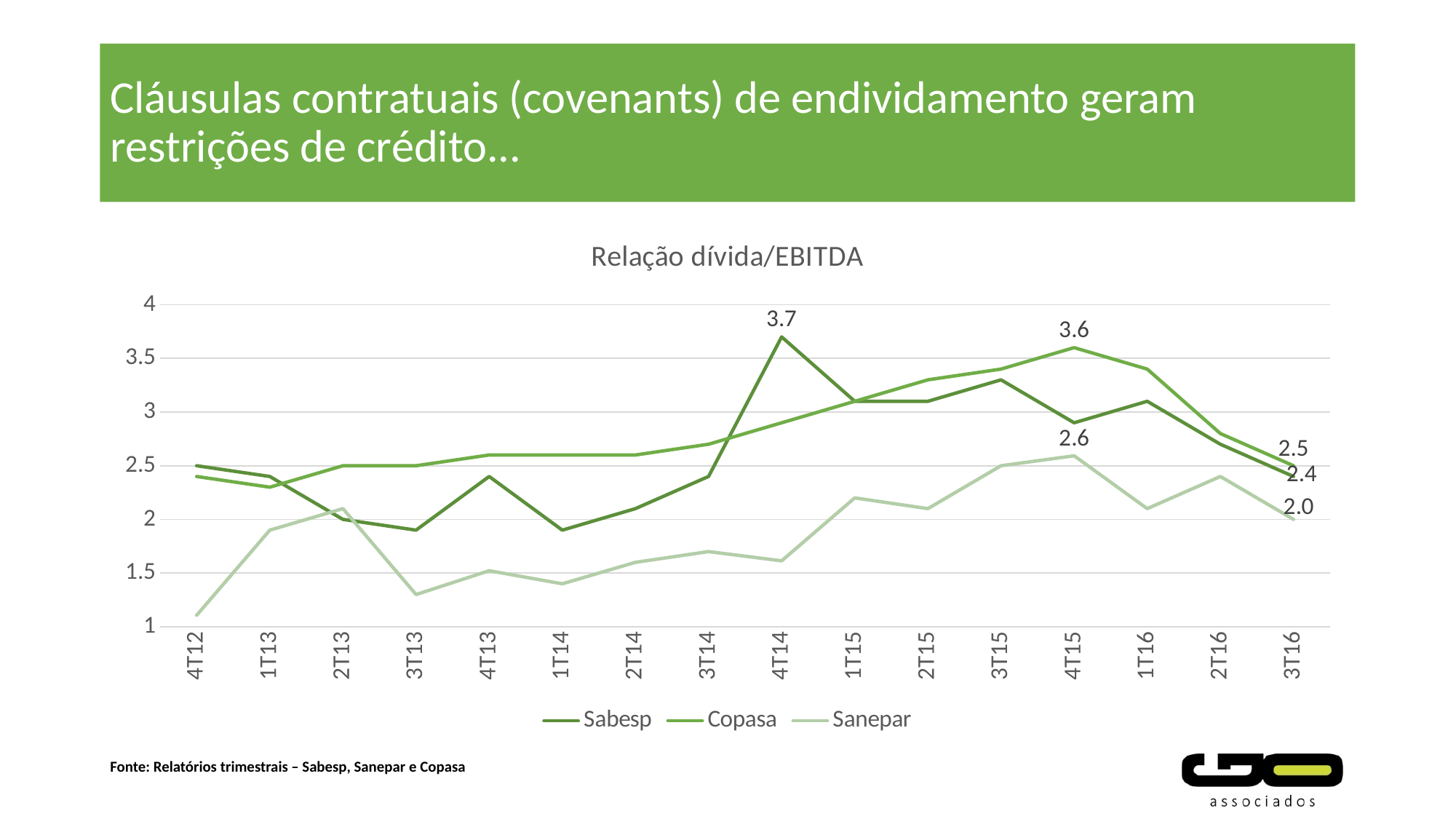
What is the value for Sanepar in 3T16? 2.0 What is the title of the chart? Relação dívida/EBITDA Is the value for Sanepar in 4T12 greater or less than 1.5? less What kind of chart is shown on the slide? line chart How many series does the legend of the chart list? 3 What is the value for Copasa in 4T15? 3.6 How many quarters are shown on the x axis of the chart? 16 Which series has the highest value in 4T14? Sabesp What is the value for Copasa in 3T16? 2.5 What is the difference between the Copasa and Sanepar values in 3T16? 0.5 What is the value for Sabesp in 4T14? 3.7 In 3T16, which is larger: the value for Copasa or the value for Sabesp? Copasa